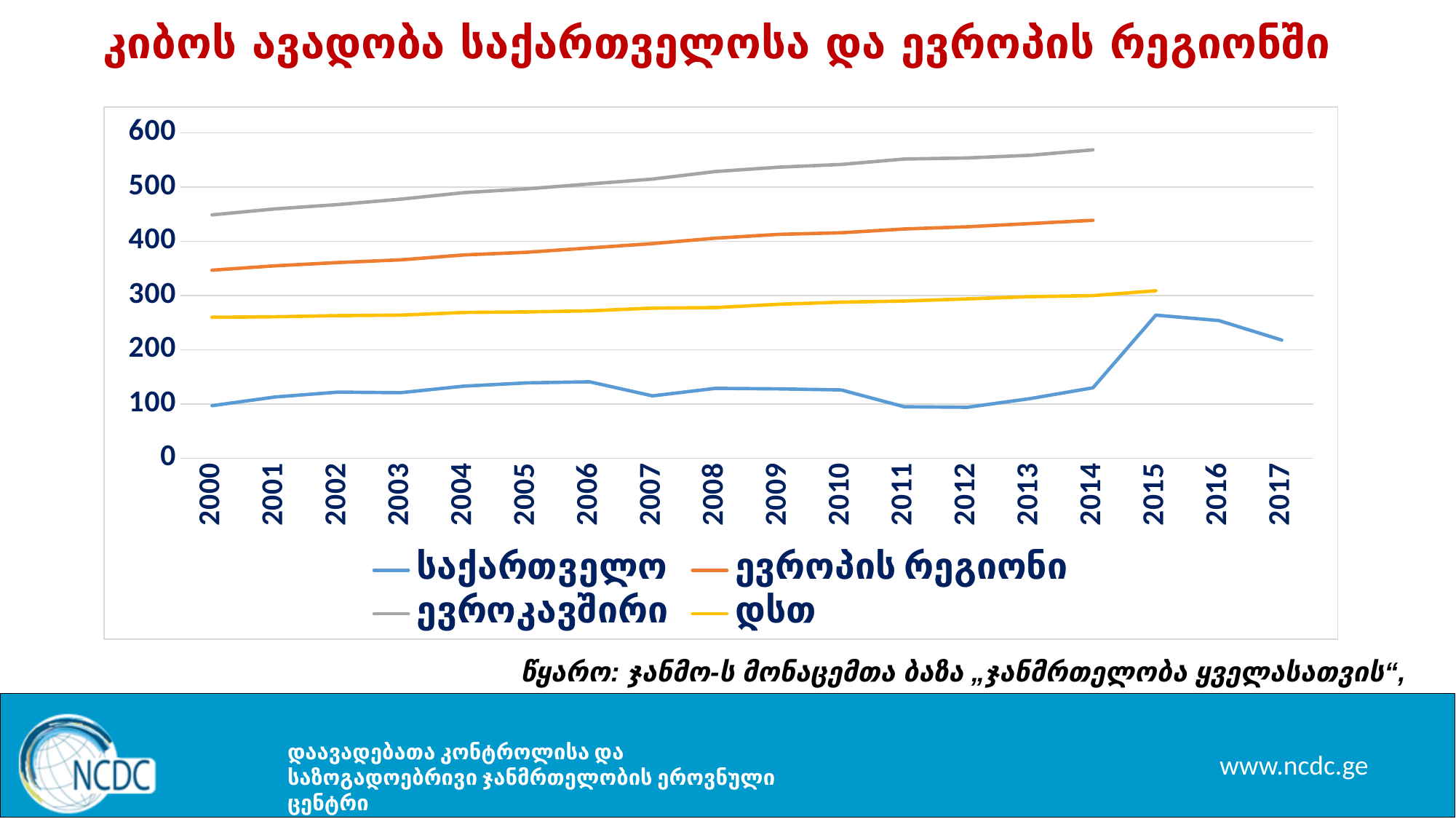
Is the value for ევროკავშირი in 2000 greater or less than 500? less Is the value for ევროკავშირი in 2014 greater or less than 500? greater Does the ევროკავშირი line rise or fall from 2000 to 2014? rises How many series does the legend list? 4 What kind of chart is shown on the slide? line chart Which series has the highest values throughout the chart? ევროკავშირი Which series is the only one with data plotted for 2015 to 2017? საქართველო In 2010, which is larger: the value for ევროპის რეგიონი or the value for საქართველო? ევროპის რეგიონი How many years are shown on the x axis? 18 Is the value for საქართველო in 2015 greater or less than 200? greater Which series has the lowest values throughout the chart? საქართველო